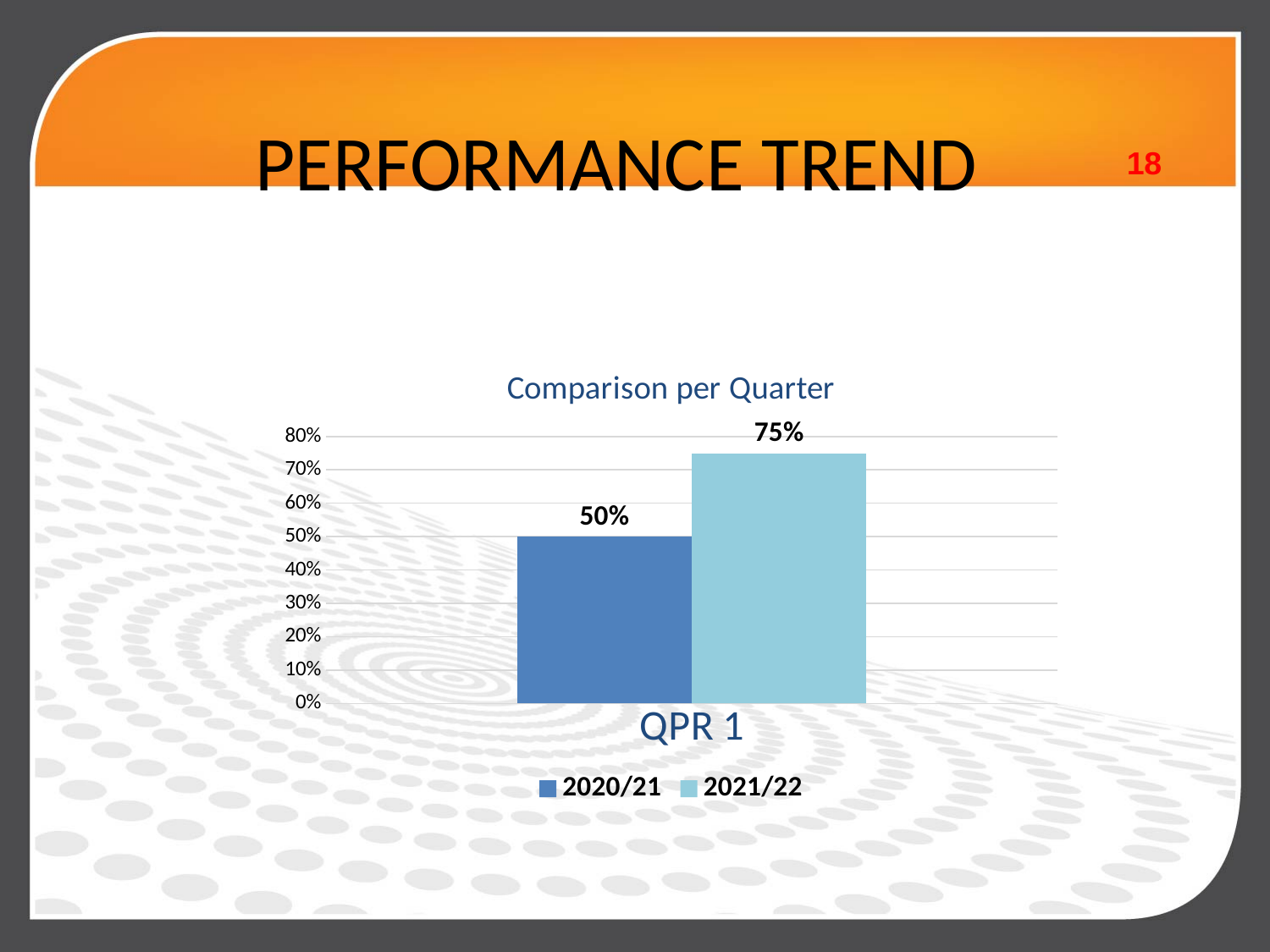
How many categories are shown on the x axis? 1 What is the difference between the 2021/22 and 2020/21 values in QPR 1? 25% What kind of chart is shown on the slide? bar chart Which series has the lower value in QPR 1? 2020/21 Is the value for 2021/22 larger or smaller than the value for 2020/21? larger Which series has the higher value in QPR 1? 2021/22 Is the value for 2020/21 greater or less than 60%? less Is the value for 2021/22 greater or less than 70%? greater What is the title of the chart? Comparison per Quarter What is the value for 2020/21 in QPR 1? 50% What is the value for 2021/22 in QPR 1? 75% How many series does the legend list? 2